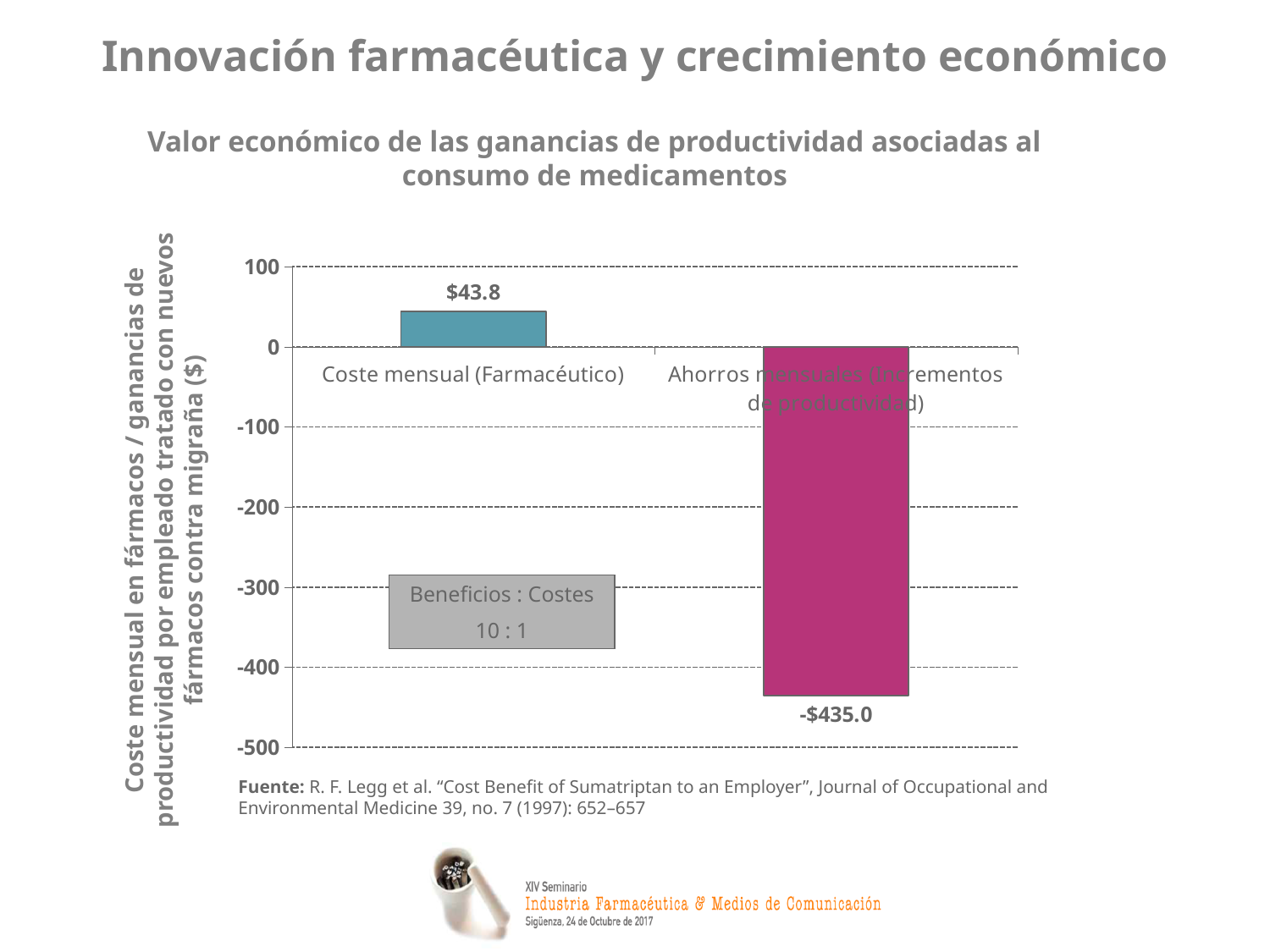
Which category has the lowest value? Ahorros mensuales (Incrementos de productividad) Which category has the highest value? Coste mensual (Farmacéutico) What is the difference between the value for Coste mensual (Farmacéutico) and the value for Ahorros mensuales (Incrementos de productividad)? $478.8 What is the value for Coste mensual (Farmacéutico)? $43.8 What is the value for Ahorros mensuales (Incrementos de productividad)? -$435.0 What is the title of the chart? Valor económico de las ganancias de productividad asociadas al consumo de medicamentos How many categories are shown in the chart? 2 Is the value for Ahorros mensuales (Incrementos de productividad) greater or less than -400? less Is the value for Coste mensual (Farmacéutico) greater or less than 100? less What kind of chart is shown on the slide? bar chart What benefits-to-costs ratio is shown in the box on the chart? 10 : 1 Which is larger, the value for Coste mensual (Farmacéutico) or the value for Ahorros mensuales (Incrementos de productividad)? Coste mensual (Farmacéutico)